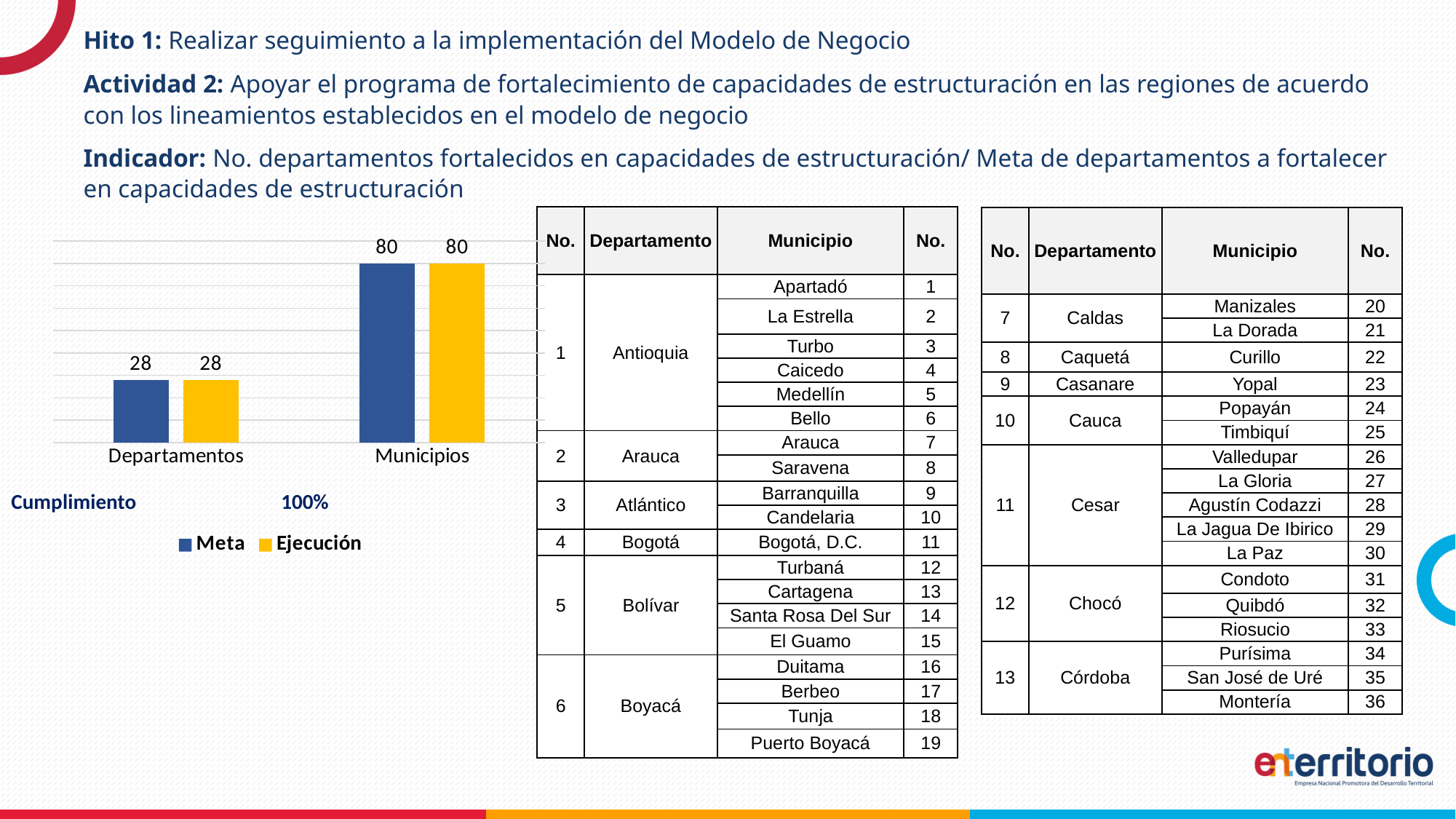
Which series in the bar chart is shown in yellow? Ejecución How many series does the legend of the bar chart list? 2 What kind of chart is shown on the slide? bar chart What is the Ejecución value for Departamentos in the bar chart? 28 What is the Ejecución value for Municipios in the bar chart? 80 What is the Meta value for Municipios in the bar chart? 80 Which category has the highest Meta value in the bar chart? Municipios Which category has the lowest Ejecución value in the bar chart? Departamentos Is the Ejecución value for Municipios larger or smaller than the Ejecución value for Departamentos? larger What is the difference between the Meta values for Municipios and Departamentos in the bar chart? 52 What is the Meta value for Departamentos in the bar chart? 28 How many categories are shown on the x axis of the bar chart? 2